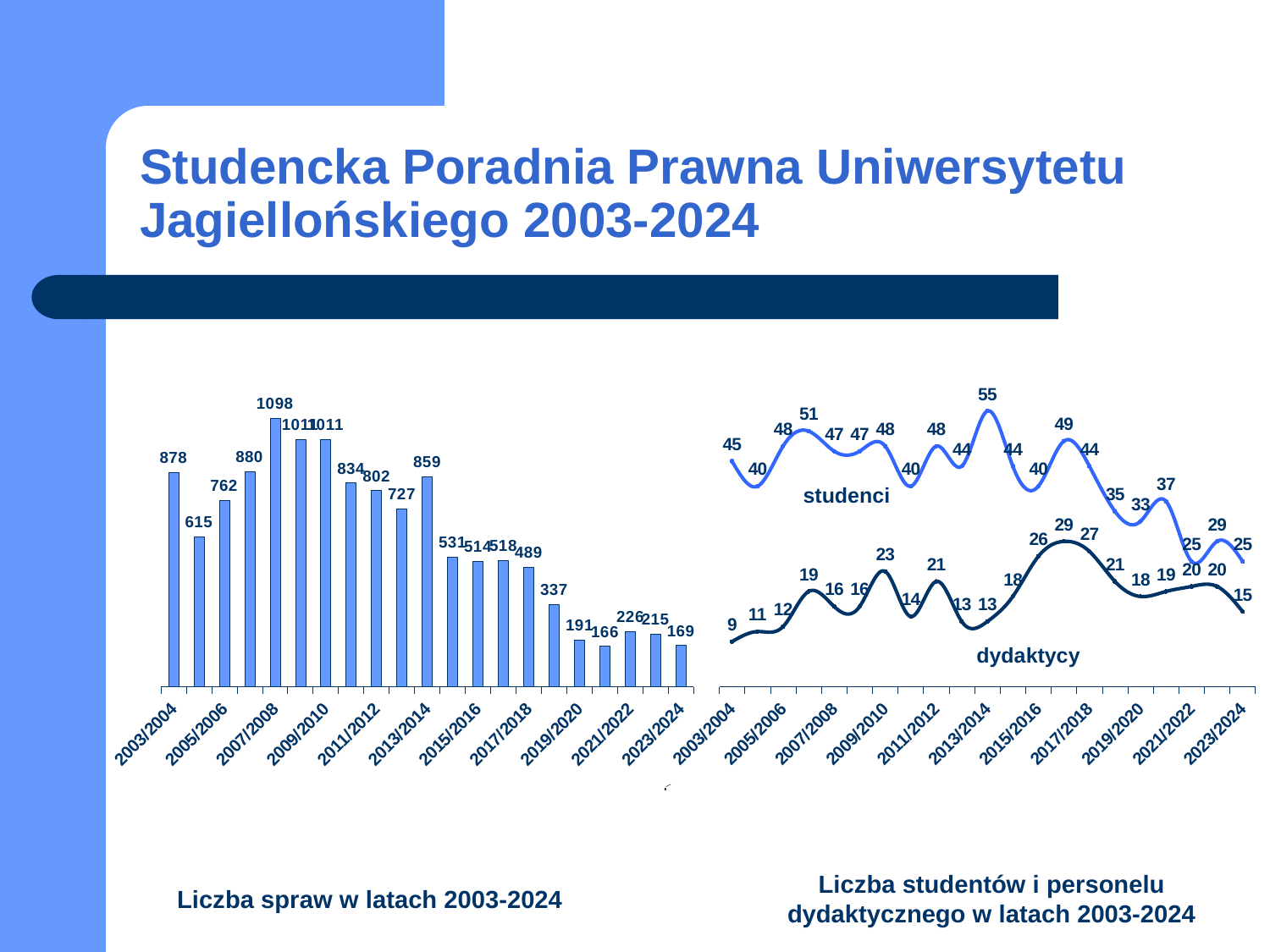
In the right chart 'Liczba studentów i personelu dydaktycznego w latach 2003-2024', what is the value for studenci in 2013/2014? 55 In the right chart 'Liczba studentów i personelu dydaktycznego w latach 2003-2024', what is the value for dydaktycy in 2003/2004? 9 How many series are plotted in the right chart 'Liczba studentów i personelu dydaktycznego w latach 2003-2024'? 2 In the bar chart 'Liczba spraw w latach 2003-2024', do the values generally rise or fall from 2013/2014 to 2023/2024? fall In the bar chart 'Liczba spraw w latach 2003-2024', what is the value for 2023/2024? 169 In the bar chart 'Liczba spraw w latach 2003-2024', which is larger: the value for 2013/2014 or the value for 2015/2016? 2013/2014 In the right chart 'Liczba studentów i personelu dydaktycznego w latach 2003-2024', what is the difference between studenci and dydaktycy in 2023/2024? 10 In the bar chart 'Liczba spraw w latach 2003-2024', what is the difference between the values for 2003/2004 and 2005/2006? 116 In the bar chart 'Liczba spraw w latach 2003-2024', what is the value for 2007/2008? 1098 What kind of chart is the left chart, 'Liczba spraw w latach 2003-2024'? bar chart In the bar chart 'Liczba spraw w latach 2003-2024', what is the value for 2003/2004? 878 In the bar chart 'Liczba spraw w latach 2003-2024', which year has the highest value? 2007/2008